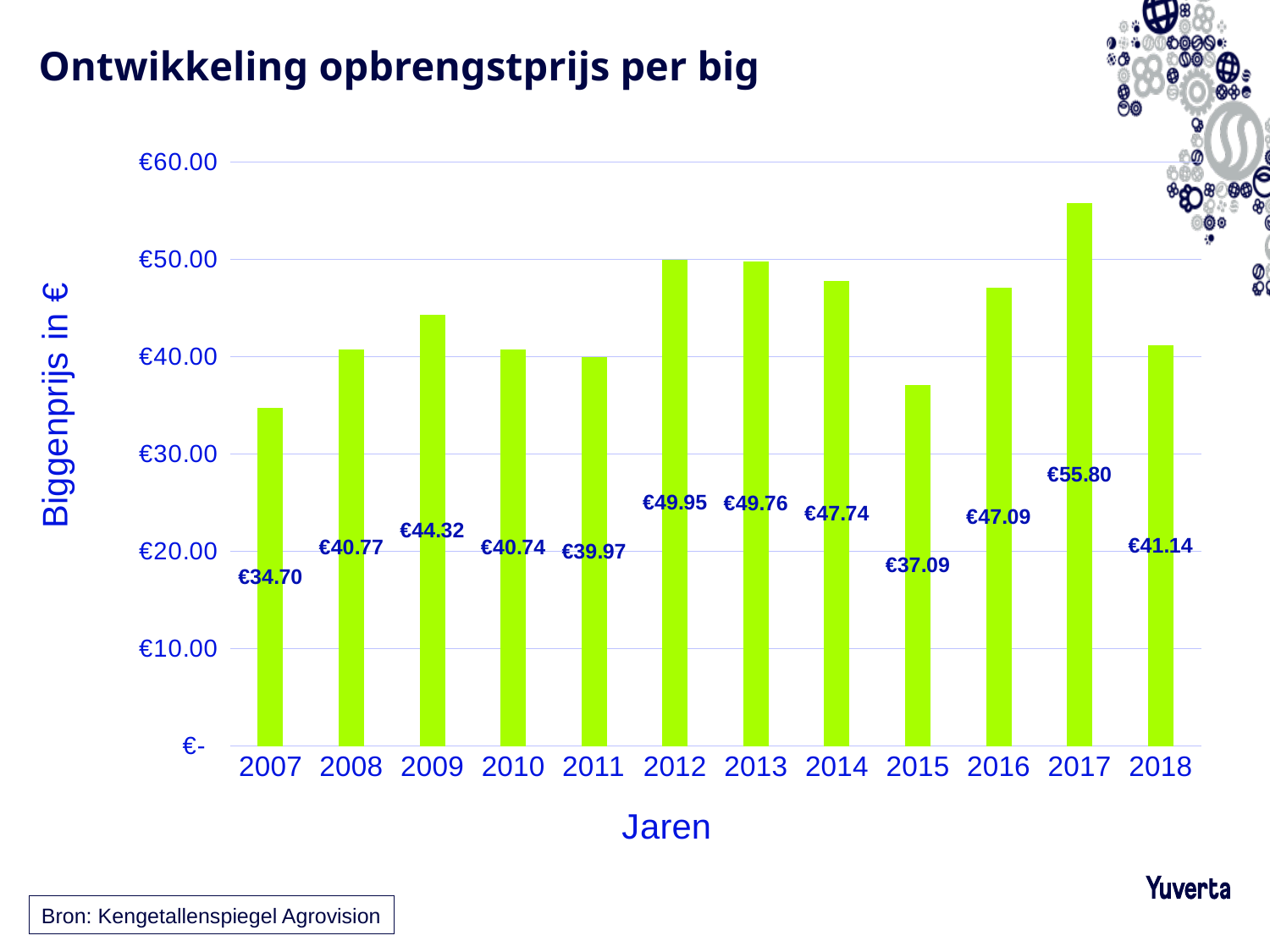
What is the value for 2007? €34.70 Is the value for 2009 greater or less than €40.00? greater What is the difference between the values for 2012 and 2011? €9.98 Which year has the lowest value? 2007 Which is larger, the value for 2014 or the value for 2016? 2014 Which year has the highest value? 2017 How many years are shown on the x axis? 12 What kind of chart is shown on the slide? bar chart What is the value for 2017? €55.80 What is the difference between the values for 2017 and 2007? €21.10 Do the values rise or fall from 2012 to 2015? fall What is the value for 2015? €37.09